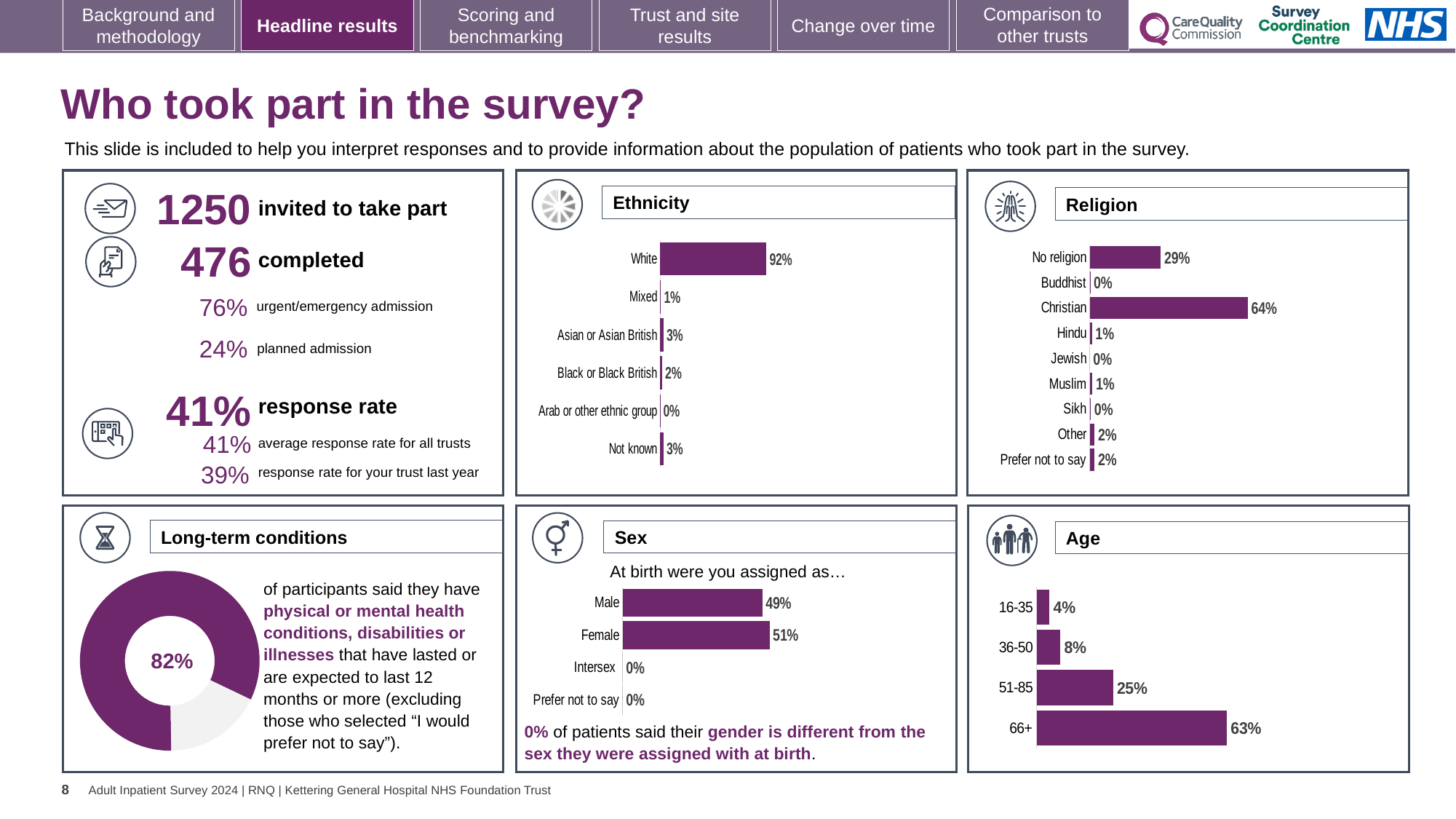
In the Sex chart, what percentage of respondents are Male? 49% In the Ethnicity chart, what percentage of respondents are White? 92% In the Age chart, do the values rise or fall as age increases from 16-35 to 66+? rise In the Ethnicity chart, how many categories are shown? 6 In the Age chart, which age group has the lowest value? 16-35 In the Religion chart, what is the difference between the Christian and No religion values? 35% In the Religion chart, what percentage of respondents are Christian? 64% In the Sex chart, which is larger, Male or Female? Female In the Age chart, what percentage of respondents are aged 66+? 63% In the Ethnicity chart, which category has the highest value? White What kind of chart is used in the Long-term conditions panel? Doughnut chart In the Religion chart, how many categories are shown? 9